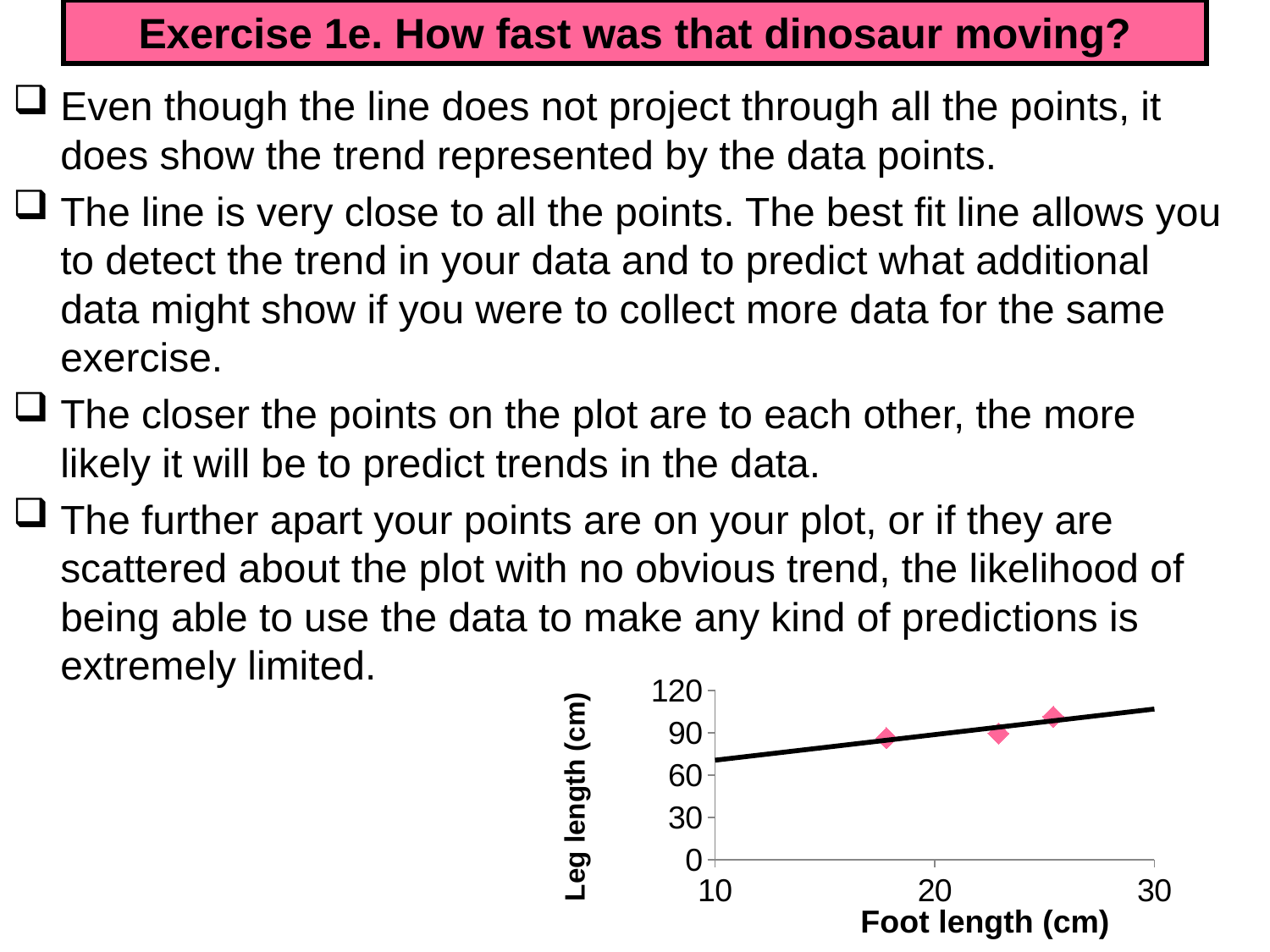
Is the foot length of the rightmost data point greater or less than 30? less What kind of chart is shown on the slide? scatter chart Does the best fit line rise or fall as foot length increases? rise Is the leg length of the rightmost data point greater or less than 120? less Is the leg length of the leftmost data point greater or less than 60? greater How many data points are plotted on the chart? 3 What is the title of the y axis of the chart? Leg length (cm) What is the highest value shown on the y axis of the chart? 120 What is the title of the x axis of the chart? Foot length (cm) Which data point has the greatest leg length: the leftmost or the rightmost? the rightmost